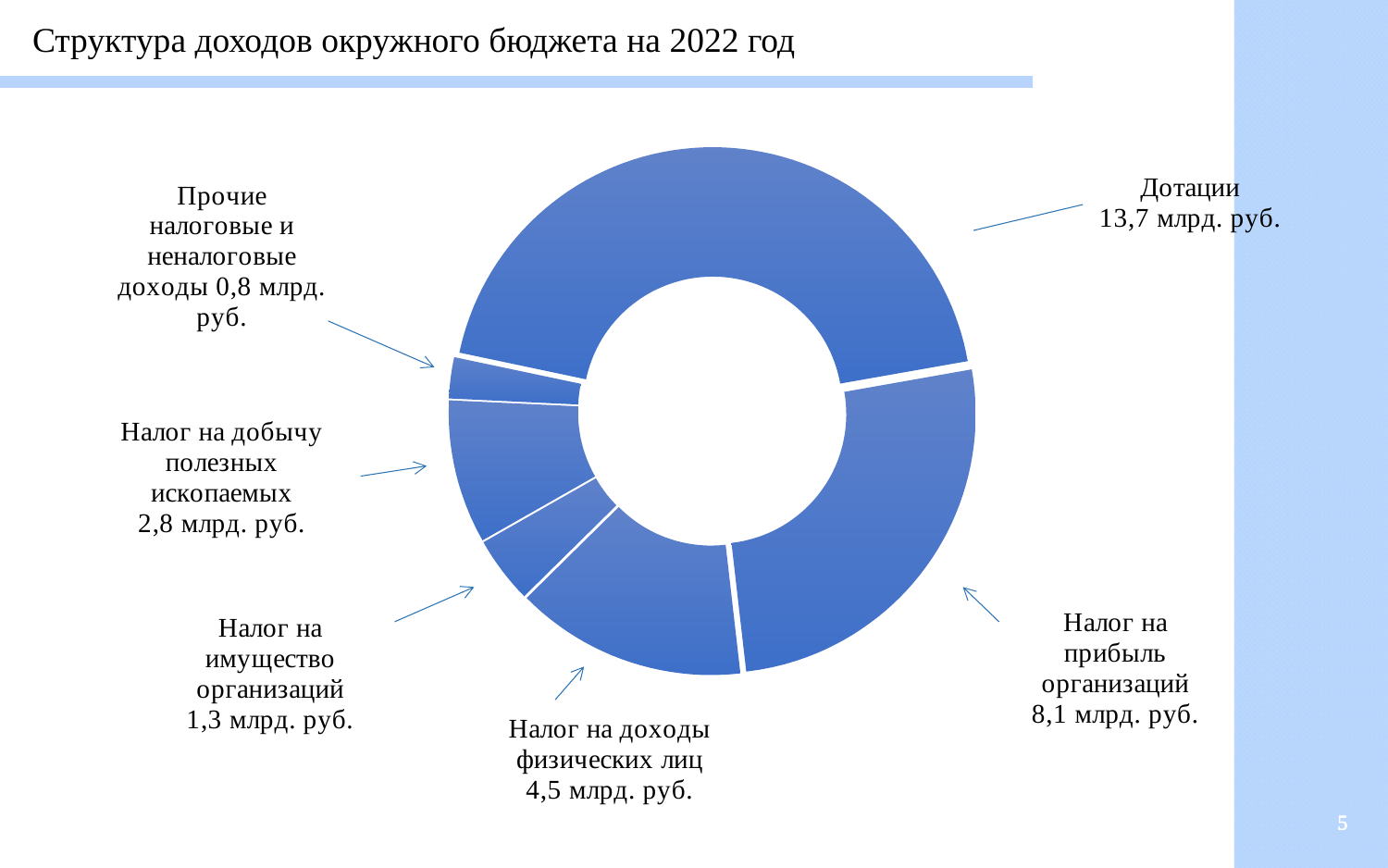
What is the value for Налог на добычу полезных ископаемых? 2,8 млрд. руб. Which category has the smallest value? Прочие налоговые и неналоговые доходы Which category has the largest value? Дотации How many categories are shown in the chart? 6 What is the value for Налог на доходы физических лиц? 4,5 млрд. руб. What is the difference between Дотации and Налог на прибыль организаций? 5,6 млрд. руб. What kind of chart is shown on the slide? Pie (donut) chart What is the value for Дотации? 13,7 млрд. руб. What is the value for Налог на прибыль организаций? 8,1 млрд. руб. What is the title of the slide? Структура доходов окружного бюджета на 2022 год Which is larger: Налог на добычу полезных ископаемых or Налог на имущество организаций? Налог на добычу полезных ископаемых What is the value for Налог на имущество организаций? 1,3 млрд. руб.